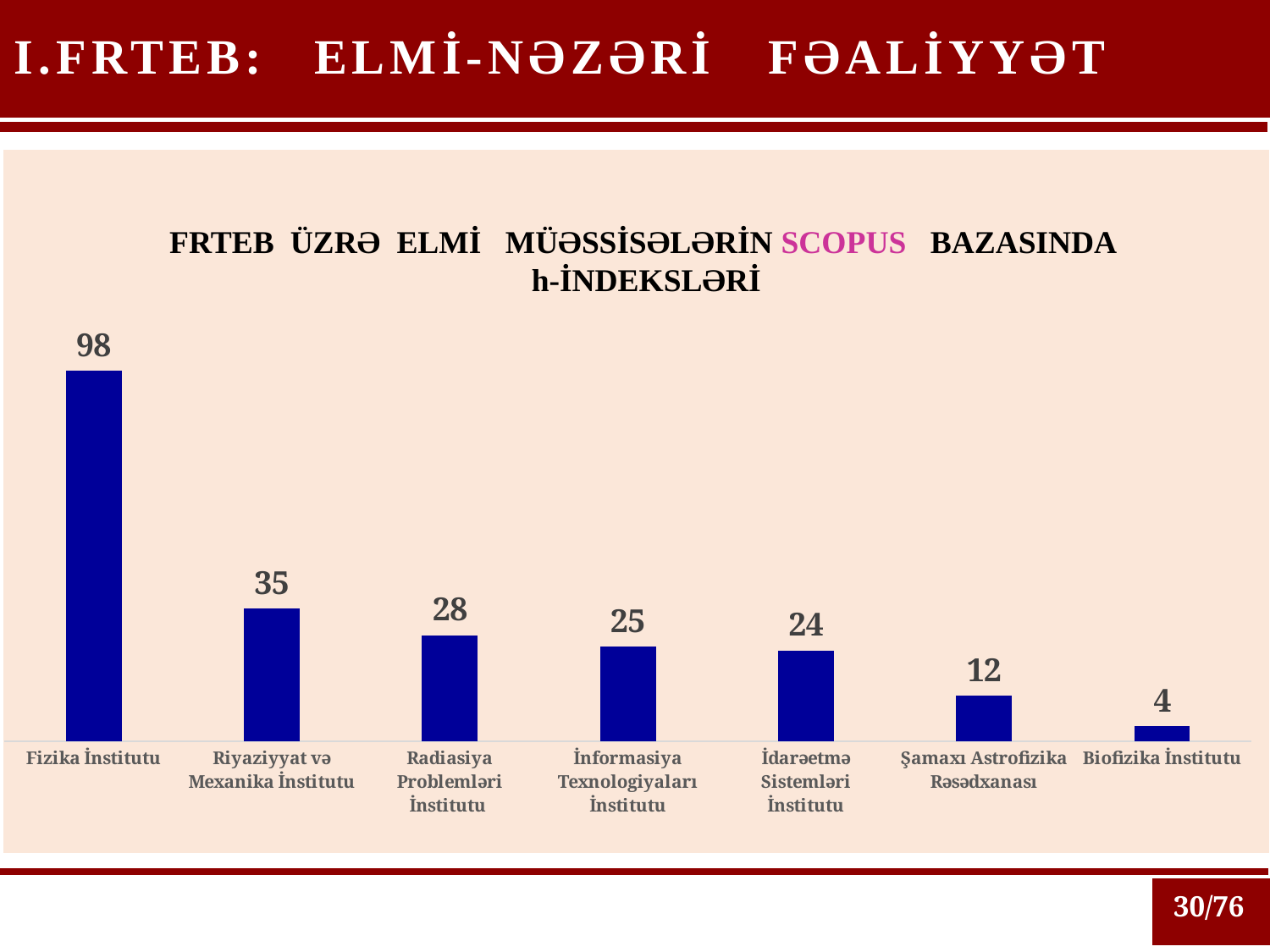
How many institutions are shown in the chart? 7 Which institution has the lowest h-index in the chart? Biofizika İnstitutu What is the h-index value shown for Fizika İnstitutu? 98 What is the difference between the h-index of Fizika İnstitutu and Riyaziyyat və Mexanika İnstitutu? 63 Which database is named in the chart title? SCOPUS What is the difference between the h-index of Radiasiya Problemləri İnstitutu and İdarəetmə Sistemləri İnstitutu? 4 What is the h-index value shown for Şamaxı Astrofizika Rəsədxanası? 12 What kind of chart is shown on the slide? Bar chart Which institution has the highest h-index in the chart? Fizika İnstitutu Which has a higher h-index: İnformasiya Texnologiyaları İnstitutu or Şamaxı Astrofizika Rəsədxanası? İnformasiya Texnologiyaları İnstitutu Do the values rise or fall from left to right across the chart? Fall What is the h-index value shown for Riyaziyyat və Mexanika İnstitutu? 35